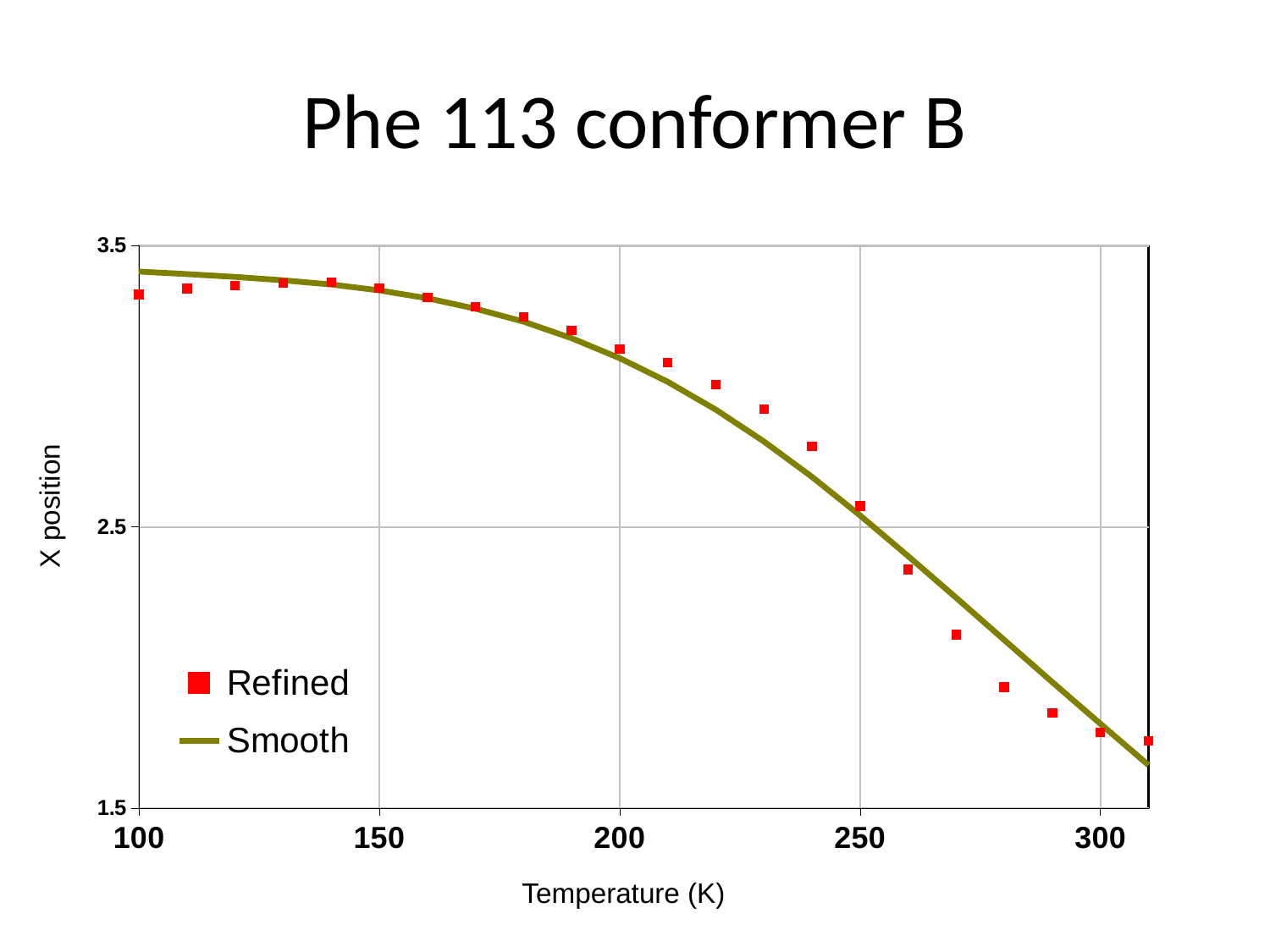
Is the Refined value at 240 K greater or less than 2.5? greater Is the Refined value at 100 K greater or less than 2.5? greater Is the Refined value at 300 K greater or less than 2.5? less What is the title of the chart? Phe 113 conformer B Which has the larger Refined value, 200 K or 300 K? 200 K Does the X position rise or fall as temperature increases along the x axis? fall What is the label of the x axis? Temperature (K) How many series does the legend list? 2 What are the names of the two series in the legend? Refined and Smooth How many Refined data points are plotted? 22 What kind of chart is shown on the slide? scatter chart with a fitted line